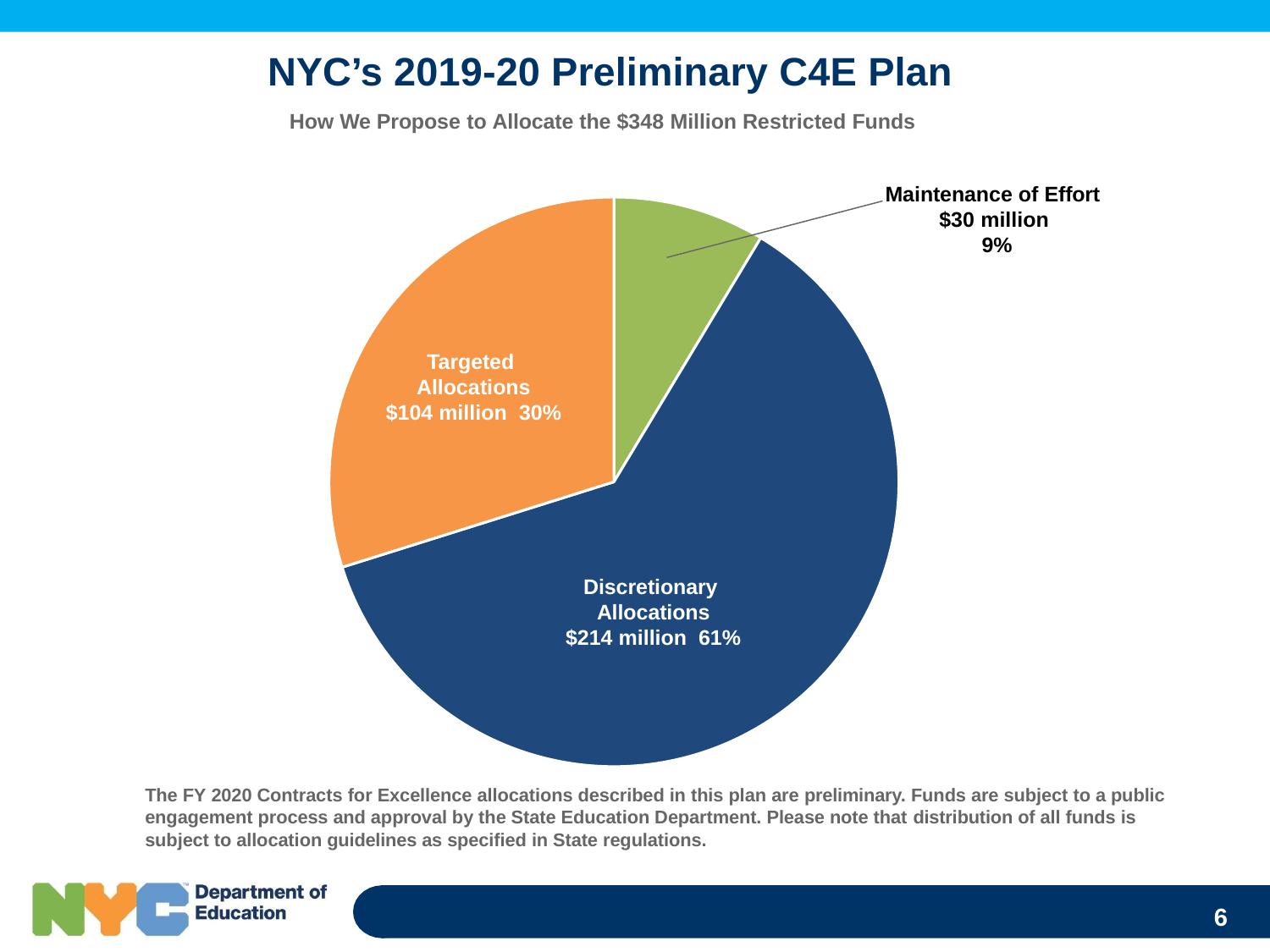
What dollar amount is allocated to Maintenance of Effort? $30 million What kind of chart is shown on the slide? pie chart What share of the pie does Discretionary Allocations represent? 61% What is the difference in dollars between Discretionary Allocations and Targeted Allocations? $110 million Which is larger, Targeted Allocations or Maintenance of Effort? Targeted Allocations How many slices does the pie chart have? 3 What share of the pie does Maintenance of Effort represent? 9% What dollar amount is allocated to Discretionary Allocations? $214 million Which category receives the largest allocation? Discretionary Allocations Which category receives the smallest allocation? Maintenance of Effort What colour is the Targeted Allocations slice? orange What dollar amount is allocated to Targeted Allocations? $104 million